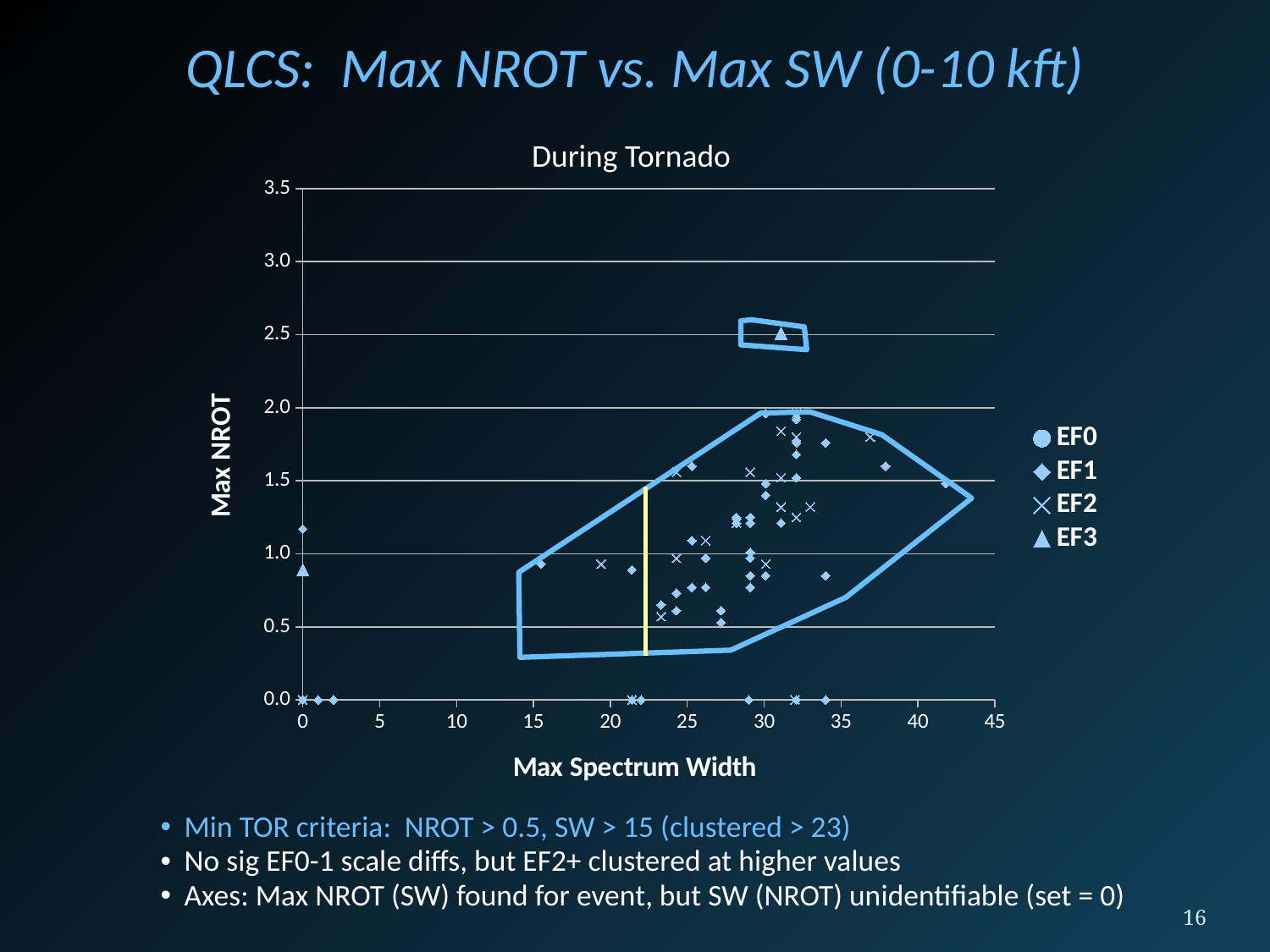
Is the Max NROT of the rightmost EF1 point greater or less than 2.0? less Is the Max NROT of the EF3 point plotted at Max Spectrum Width 0 greater or less than 0.5? greater How many EF3 points are plotted on the chart? 2 Is the Max NROT of the highest EF3 point greater or less than 2.0? greater What is the title of the chart? During Tornado How many series does the legend list? 4 Which series contains the point with the highest Max NROT value? EF3 What kind of chart is shown on the slide? scatter chart What are the series names listed in the legend? EF0, EF1, EF2, EF3